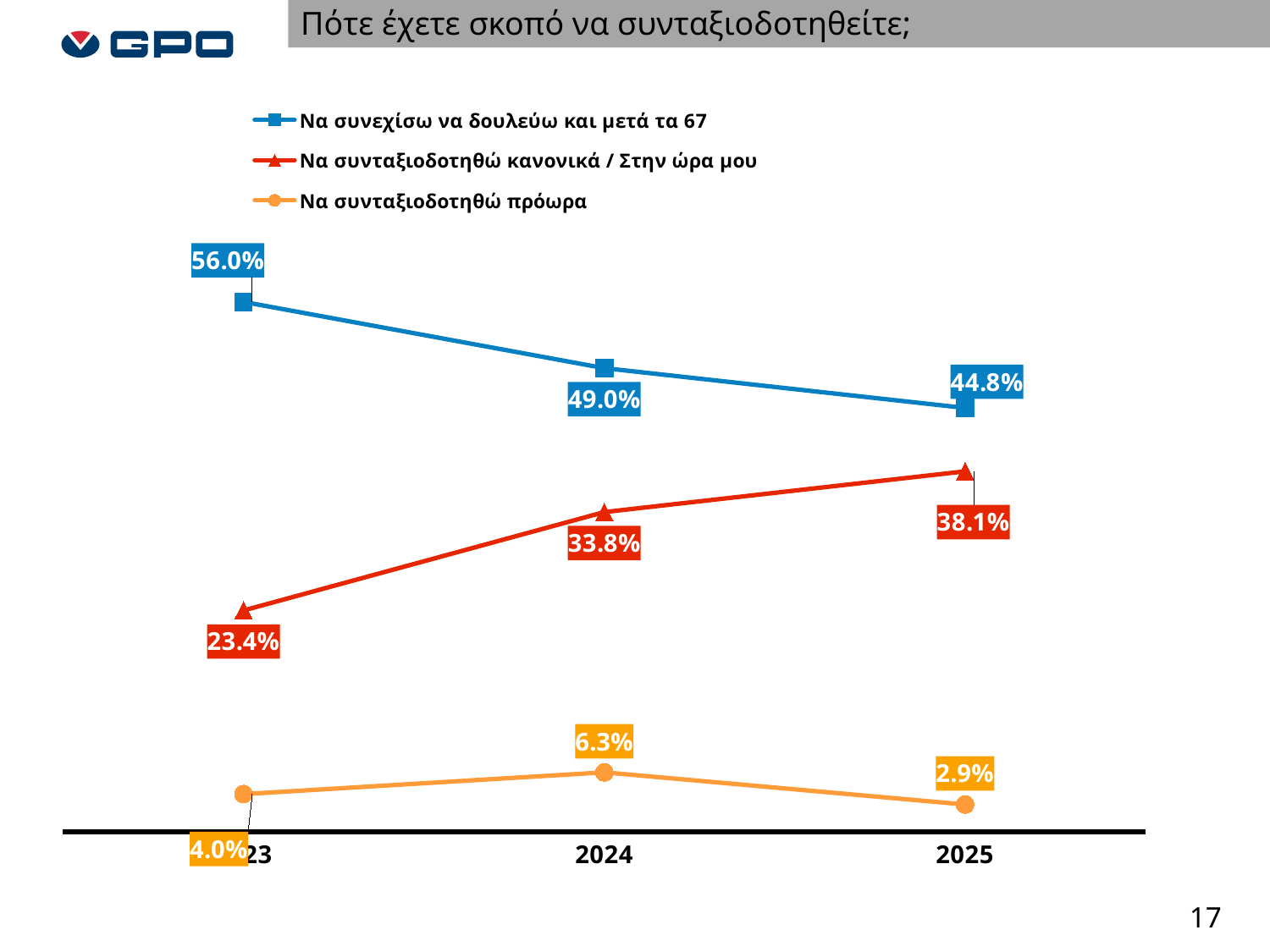
In which year is the value for 'Να συνταξιοδοτηθώ πρόωρα' lowest? 2025 Does the value for 'Να συνεχίσω να δουλεύω και μετά τα 67' rise or fall from 2023 to 2025? fall Which series has the larger value in 2024: 'Να συνταξιοδοτηθώ κανονικά / Στην ώρα μου' or 'Να συνταξιοδοτηθώ πρόωρα'? Να συνταξιοδοτηθώ κανονικά / Στην ώρα μου What kind of chart is shown on the slide? line chart In which year is the value for 'Να συνταξιοδοτηθώ κανονικά / Στην ώρα μου' highest? 2025 What is the value for 'Να συνεχίσω να δουλεύω και μετά τα 67' in 2024? 49.0% What is the value for 'Να συνταξιοδοτηθώ πρόωρα' in 2024? 6.3% What is the value for 'Να συνεχίσω να δουλεύω και μετά τα 67' in 2025? 44.8% What is the difference between the 2025 values for 'Να συνεχίσω να δουλεύω και μετά τα 67' and 'Να συνταξιοδοτηθώ κανονικά / Στην ώρα μου'? 6.7% How many years are plotted on the x axis? 3 How many series does the legend list? 3 What is the value for 'Να συνταξιοδοτηθώ κανονικά / Στην ώρα μου' in 2025? 38.1%